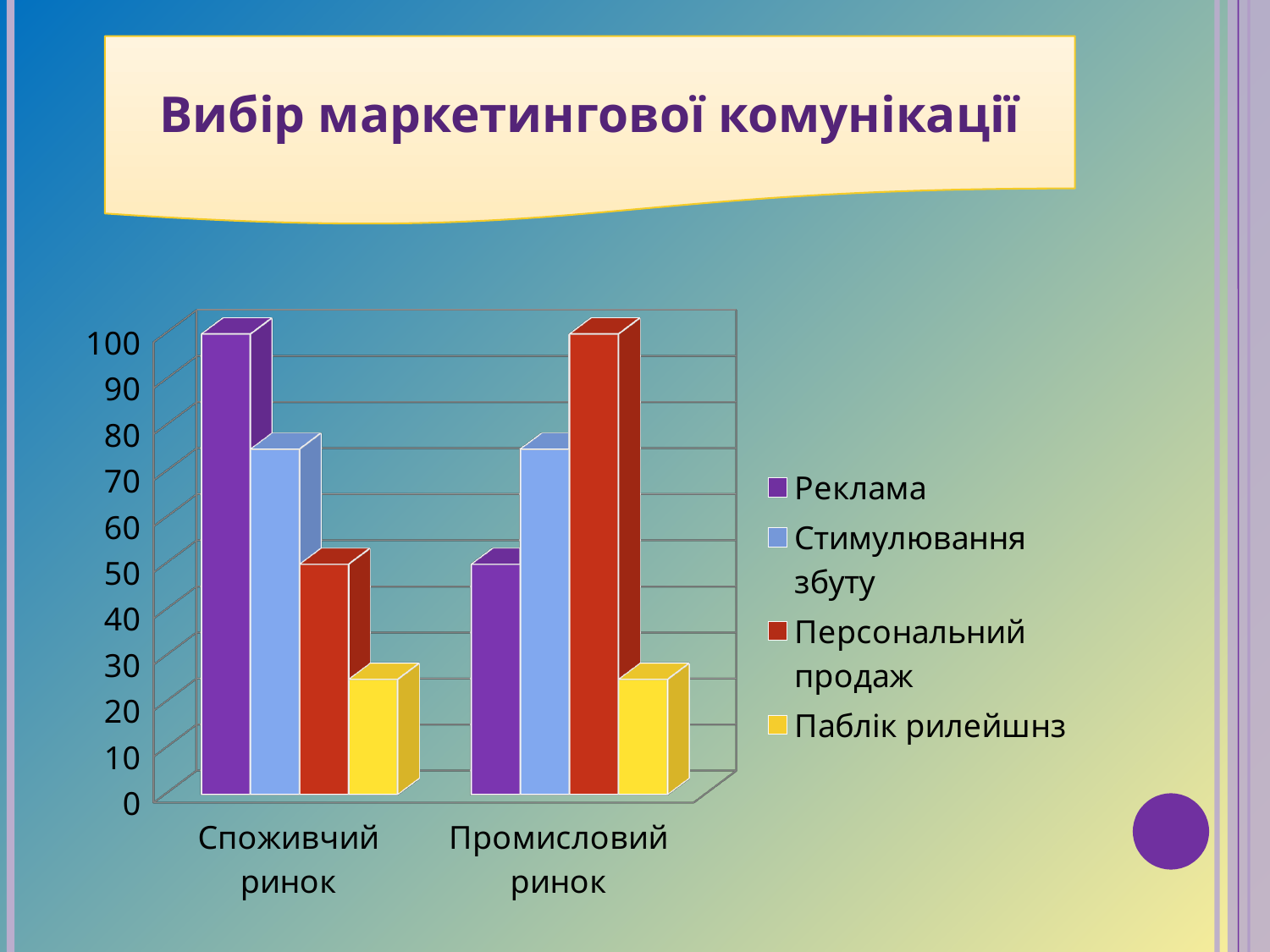
How many series does the chart legend list? 4 What is the title of the slide containing the chart? Вибір маркетингової комунікації Is the value of Реклама for Споживчий ринок greater or less than 90? greater Which series has the lowest value for Споживчий ринок? Паблік рилейшнз Is the value of Стимулювання збуту for Промисловий ринок greater or less than 60? greater Which series has the lowest value for Промисловий ринок? Паблік рилейшнз Which series has the highest value for Споживчий ринок? Реклама Which series has the highest value for Промисловий ринок? Персональний продаж Which is larger: Реклама for Споживчий ринок or Реклама for Промисловий ринок? Реклама for Споживчий ринок How many categories are shown on the x axis of the chart? 2 Is the value of Паблік рилейшнз for Промисловий ринок greater or less than 40? less What kind of chart is shown on the slide? bar chart